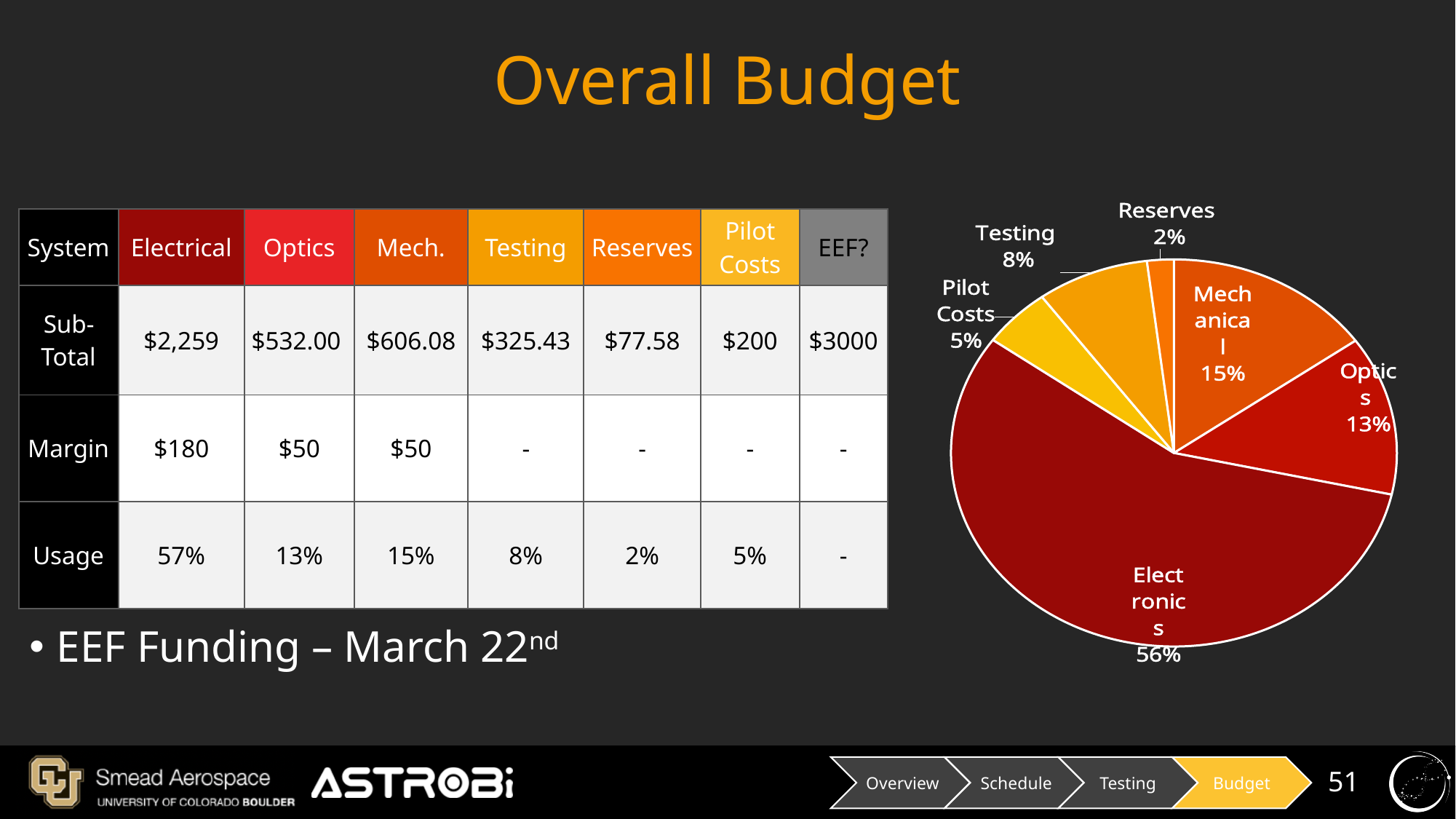
In the pie chart, which is larger, Mechanical or Optics? Mechanical In the pie chart, what share does Electronics have? 56% In the pie chart, what is the difference in percentage points between Testing and Pilot Costs? 3 Which slice of the pie chart is the largest? Electronics In the pie chart, what share does Optics have? 13% In the pie chart, what is the difference in percentage points between Electronics and Mechanical? 41 In the pie chart, what share does Mechanical have? 15% Which slice of the pie chart is the smallest? Reserves In the pie chart, what share does Testing have? 8% How many slices does the pie chart have? 6 What kind of chart is shown on the right of the slide? pie chart In the pie chart, what share does Reserves have? 2%